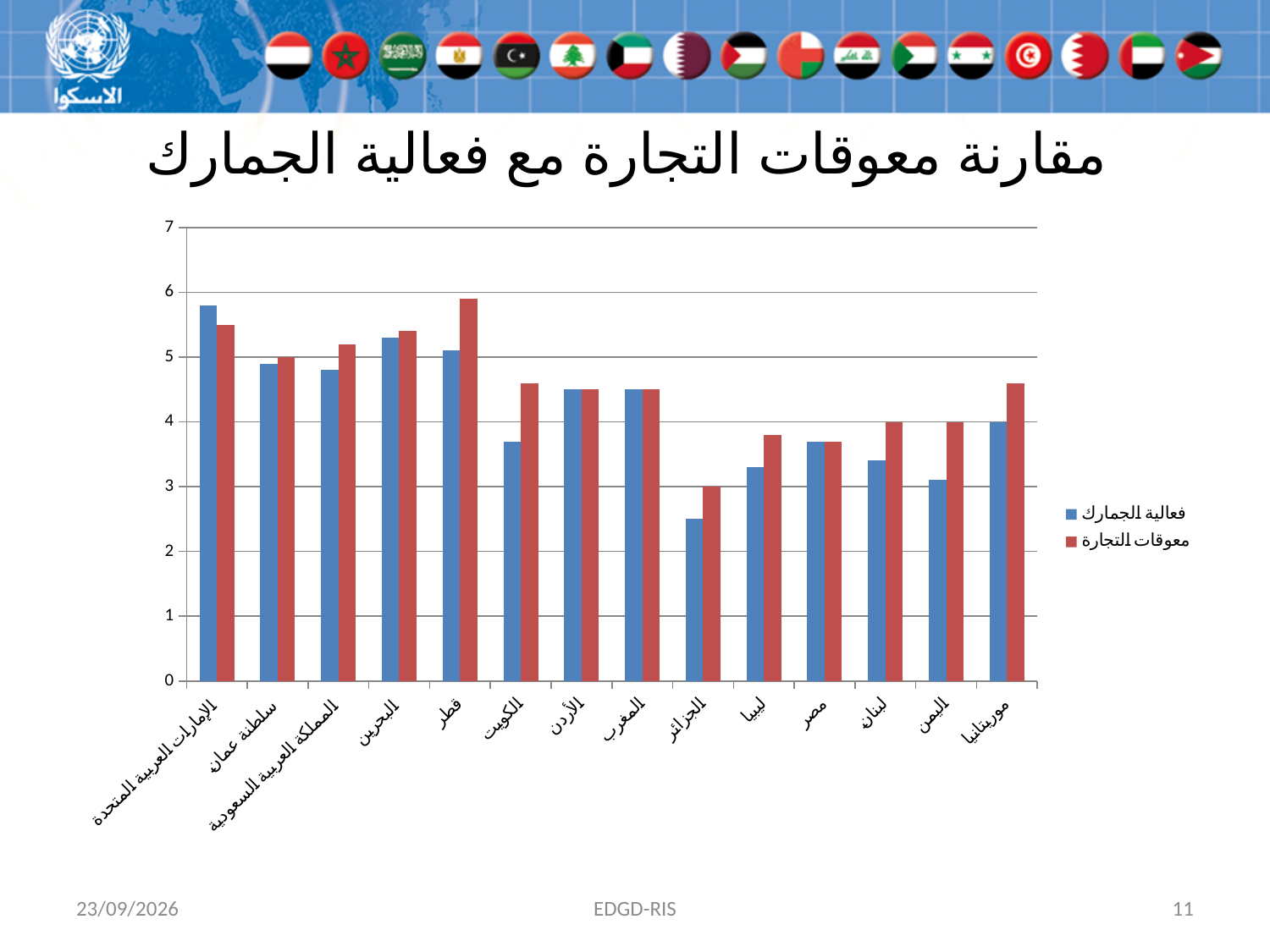
How many countries are shown on the x axis? 14 Which country has the highest value for فعالية الجمارك? الإمارات العربية المتحدة Which country has the highest value for معوقات التجارة? قطر Which colour represents معوقات التجارة in the legend? red Which country has the lowest value for فعالية الجمارك? الجزائر Which country has the lowest value for معوقات التجارة? الجزائر For الكويت, which is larger: فعالية الجمارك or معوقات التجارة? معوقات التجارة How many series does the legend list? 2 Is the value of معوقات التجارة for قطر greater or less than 5? greater What kind of chart is shown on the slide? bar chart Is the value of فعالية الجمارك for الكويت greater or less than 4? less Is the value of فعالية الجمارك for الجزائر greater or less than 3? less